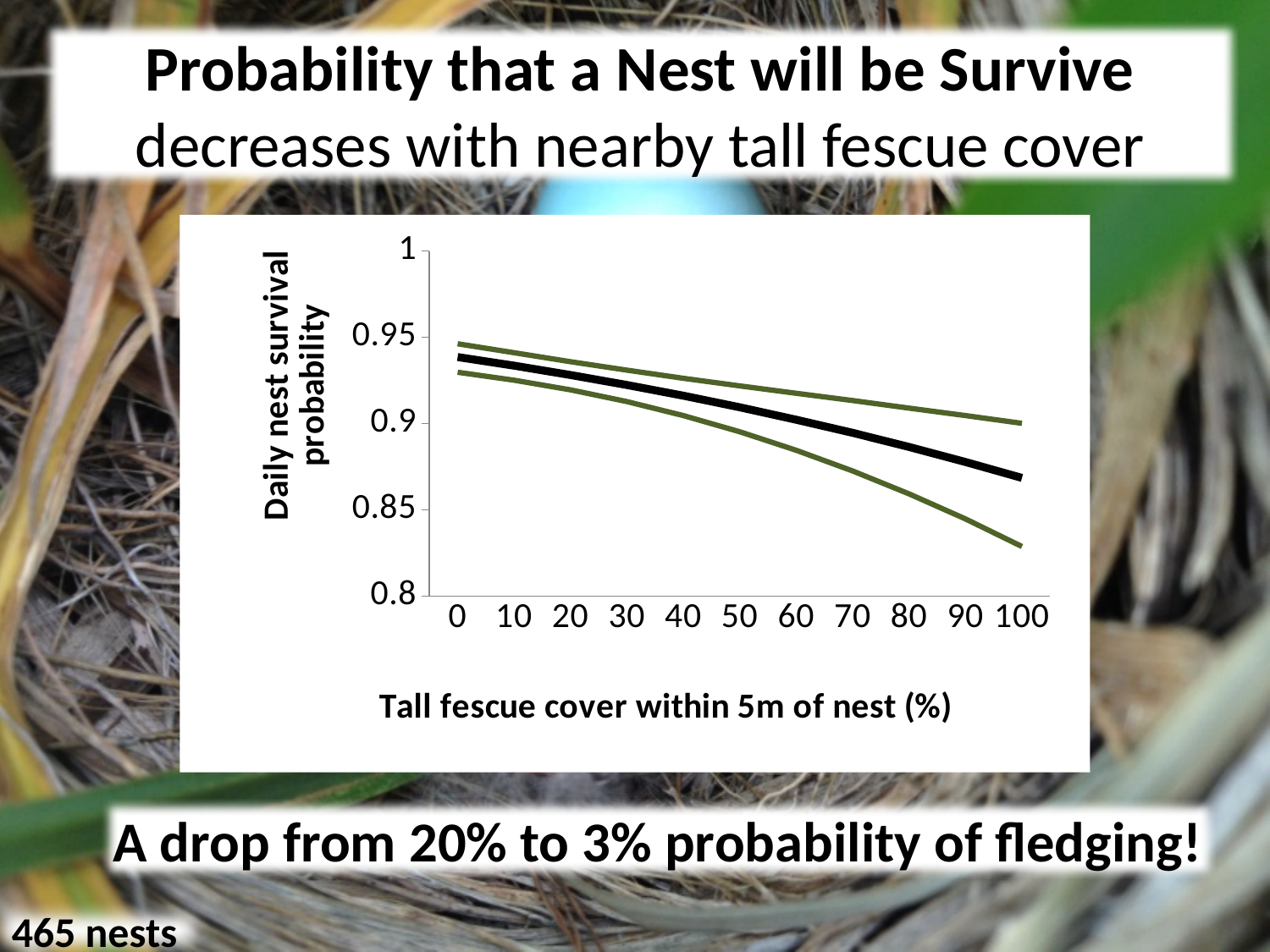
What is the label of the x axis? Tall fescue cover within 5m of nest (%) Is the black line's value at 100% tall fescue cover greater or less than its value at 0% cover? less What is the label of the y axis? Daily nest survival probability Is the value of the black (middle) line at 0% tall fescue cover greater or less than 0.95? less Is the value of the black (middle) line at 100% tall fescue cover greater or less than 0.85? greater Is the value of the black (middle) line at 0% tall fescue cover greater or less than 0.9? greater How many lines are plotted on the chart? 3 How many tick labels are shown on the x axis? 11 Does daily nest survival probability rise or fall as tall fescue cover increases from 0 to 100%? fall What kind of chart is shown on the slide? line chart